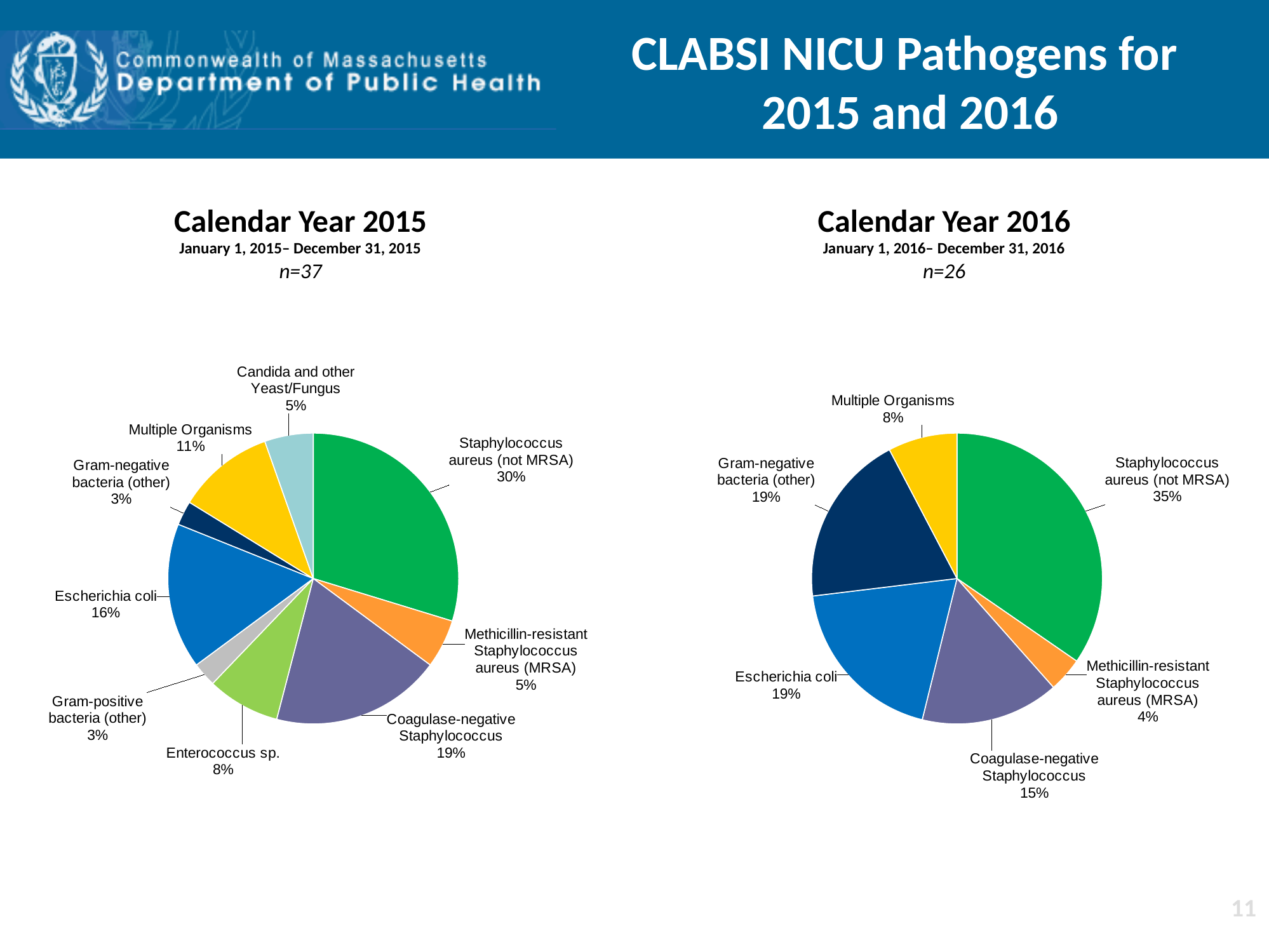
What is the n value shown for the Calendar Year 2016 chart? n=26 What type of chart is used for Calendar Year 2016? Pie chart In the Calendar Year 2016 pie chart, which is larger: the share for Coagulase-negative Staphylococcus or the share for Multiple Organisms? Coagulase-negative Staphylococcus How many slices does the Calendar Year 2016 pie chart have? 6 In the Calendar Year 2015 pie chart, what share is Multiple Organisms? 11% In the Calendar Year 2016 pie chart, what share is Escherichia coli? 19% In the Calendar Year 2016 pie chart, what is the difference between the shares for Staphylococcus aureus (not MRSA) and Gram-negative bacteria (other)? 16% In the Calendar Year 2015 pie chart, which pathogen category has the largest share? Staphylococcus aureus (not MRSA) In the Calendar Year 2016 pie chart, which pathogen category has the smallest share? Methicillin-resistant Staphylococcus aureus (MRSA) In the Calendar Year 2015 pie chart, what is the difference between the shares for Coagulase-negative Staphylococcus and Enterococcus sp.? 11% How many slices does the Calendar Year 2015 pie chart have? 9 In the Calendar Year 2015 pie chart, what share is Staphylococcus aureus (not MRSA)? 30%